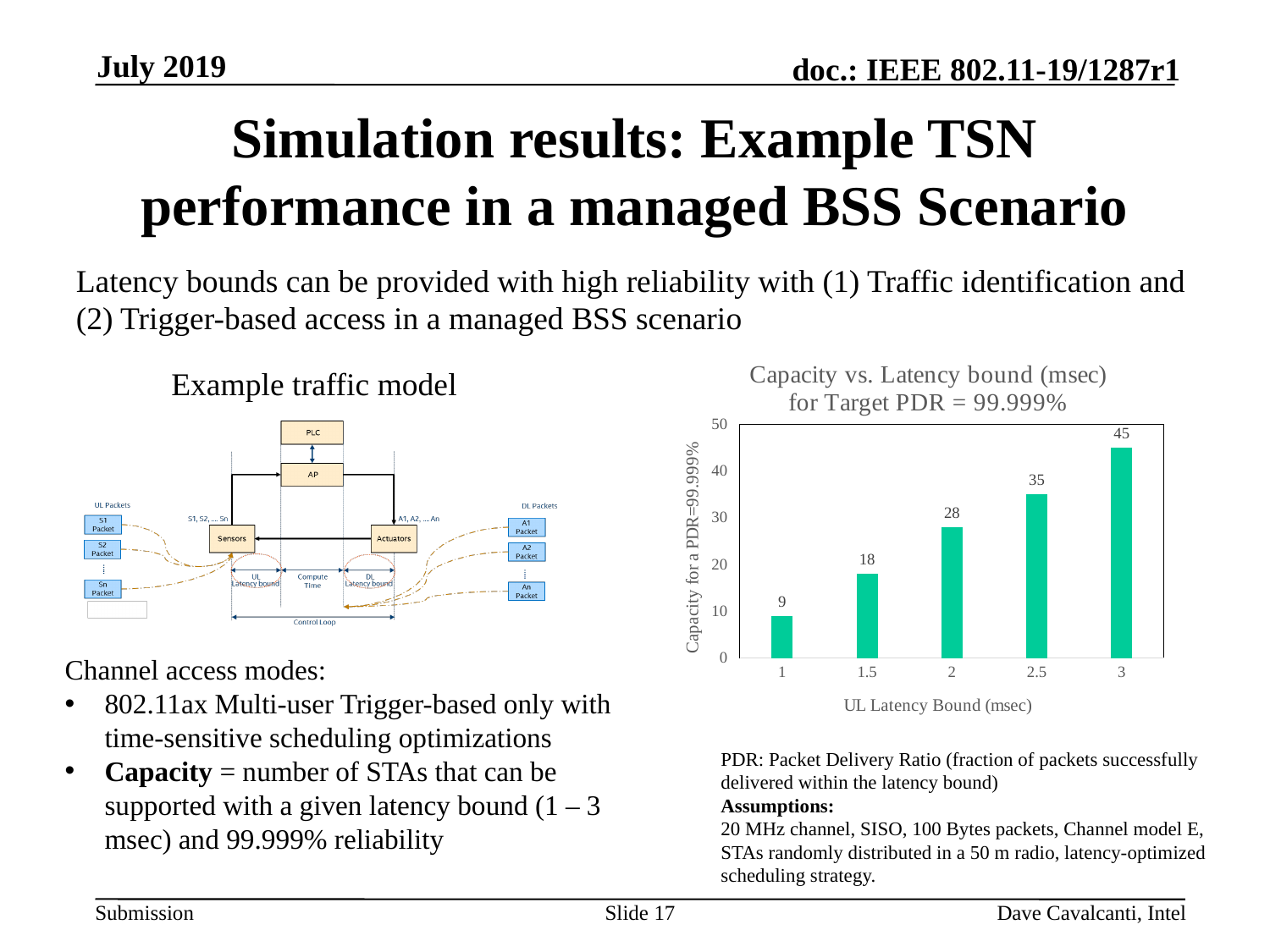
Does capacity rise or fall as the UL latency bound increases? rise Is the capacity for a UL latency bound of 1.5 msec greater or less than 20? less What is the capacity for a UL latency bound of 3 msec? 45 What is the capacity for a UL latency bound of 2 msec? 28 Which has a larger capacity, the 2 msec or the 2.5 msec latency bound? 2.5 What type of chart is used to show capacity vs. latency bound? bar chart What is the difference in capacity between the 2.5 msec and 1.5 msec latency bounds? 17 What is the title of the chart? Capacity vs. Latency bound (msec) for Target PDR = 99.999% What is the capacity for a UL latency bound of 1 msec? 9 How many UL latency bound values are plotted in the chart? 5 Which UL latency bound has the highest capacity? 3 Which UL latency bound has the lowest capacity? 1